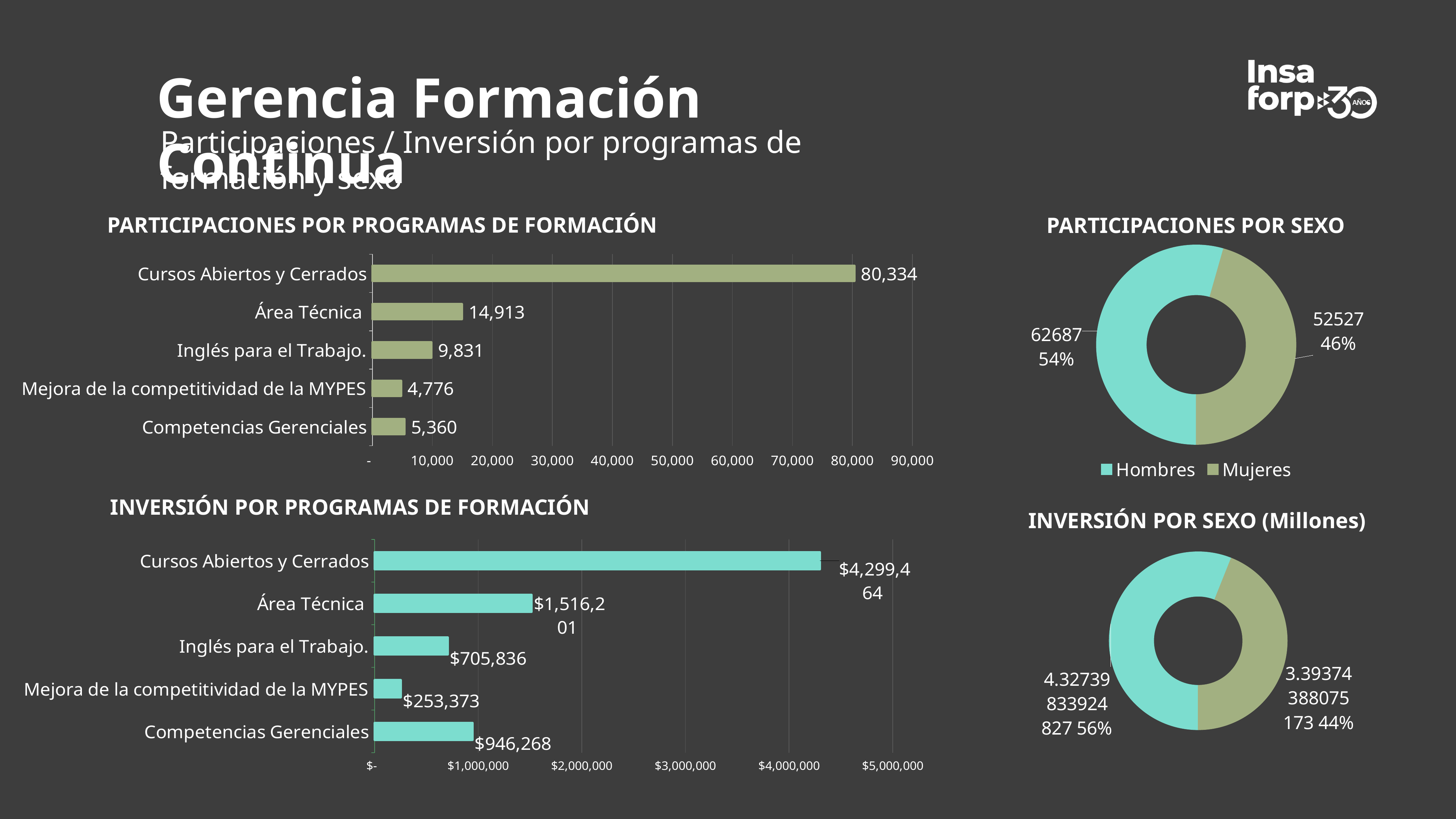
In the 'INVERSIÓN POR PROGRAMAS DE FORMACIÓN' chart, what is the value for Competencias Gerenciales? $946,268 In the 'PARTICIPACIONES POR SEXO' chart, what is the value for Hombres? 62687 In the 'PARTICIPACIONES POR PROGRAMAS DE FORMACIÓN' chart, what is the value for Cursos Abiertos y Cerrados? 80,334 In the 'PARTICIPACIONES POR SEXO' chart, what share of participations corresponds to Mujeres? 46% In the 'INVERSIÓN POR SEXO (Millones)' chart, what percentage corresponds to Hombres? 56% In the 'INVERSIÓN POR PROGRAMAS DE FORMACIÓN' chart, which is larger: Inglés para el Trabajo or Competencias Gerenciales? Competencias Gerenciales In the 'PARTICIPACIONES POR PROGRAMAS DE FORMACIÓN' chart, which program has the lowest number of participations? Mejora de la competitividad de la MYPES In the 'PARTICIPACIONES POR SEXO' chart, how many series does the legend list? 2 In the 'INVERSIÓN POR PROGRAMAS DE FORMACIÓN' chart, is the value for Cursos Abiertos y Cerrados greater or less than $4,000,000? greater In the 'PARTICIPACIONES POR PROGRAMAS DE FORMACIÓN' chart, how many programs are shown? 5 In the 'PARTICIPACIONES POR PROGRAMAS DE FORMACIÓN' chart, what is the difference between Área Técnica and Inglés para el Trabajo? 5,082 What kind of chart is 'INVERSIÓN POR PROGRAMAS DE FORMACIÓN'? Bar chart